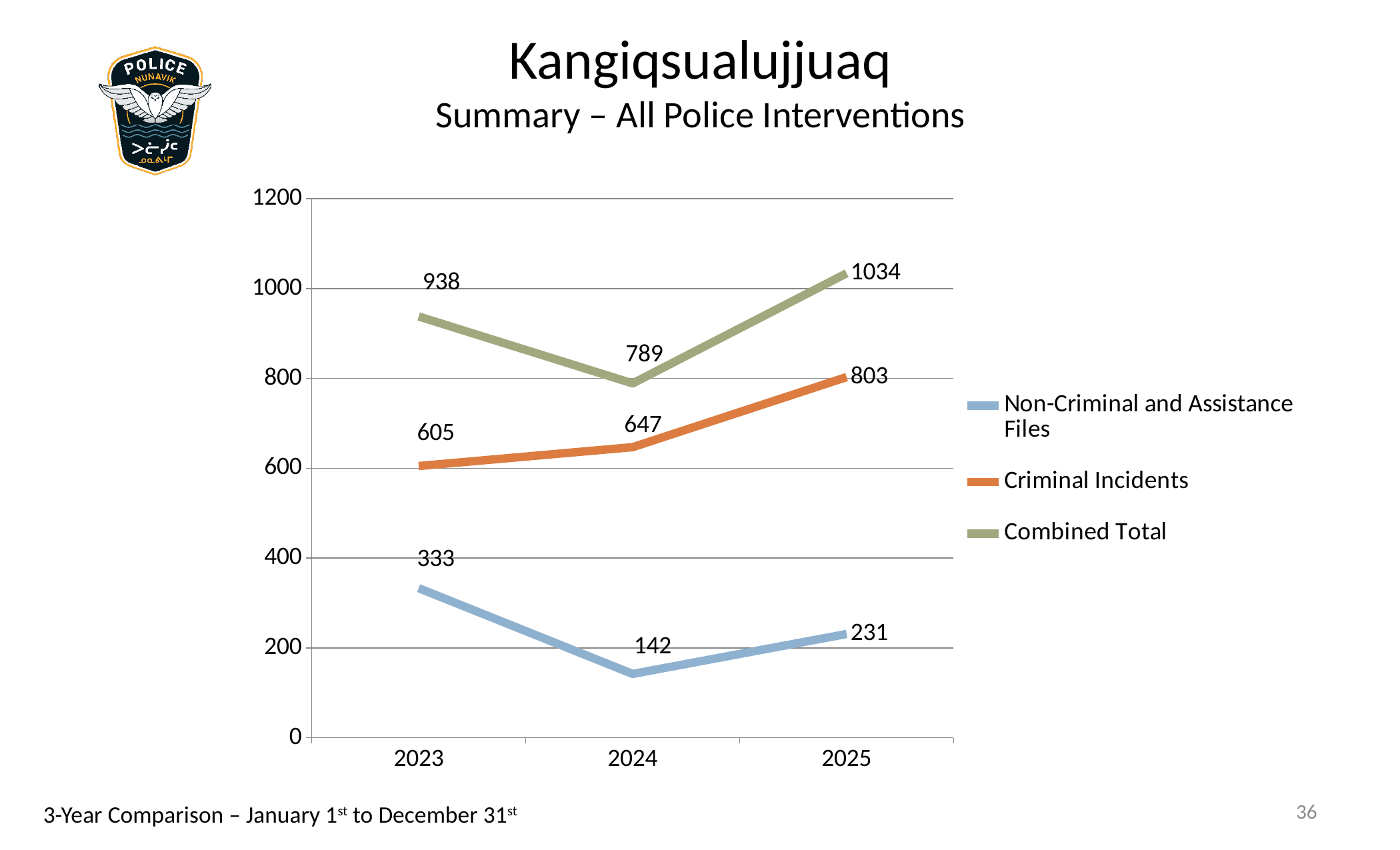
What kind of chart is shown on the slide? line chart Which is larger: Criminal Incidents in 2024 or Non-Criminal and Assistance Files in 2024? Criminal Incidents in 2024 What is the Combined Total for 2025? 1034 Is the Combined Total for 2023 greater or less than 800? greater What is the value for Criminal Incidents in 2024? 647 How many series does the legend list? 3 In which year is the Combined Total lowest? 2024 What is the difference between Criminal Incidents in 2025 and 2023? 198 How many years are shown on the x axis? 3 What is the difference between Non-Criminal and Assistance Files in 2023 and 2024? 191 In which year are Criminal Incidents highest? 2025 What is the value for Non-Criminal and Assistance Files in 2023? 333